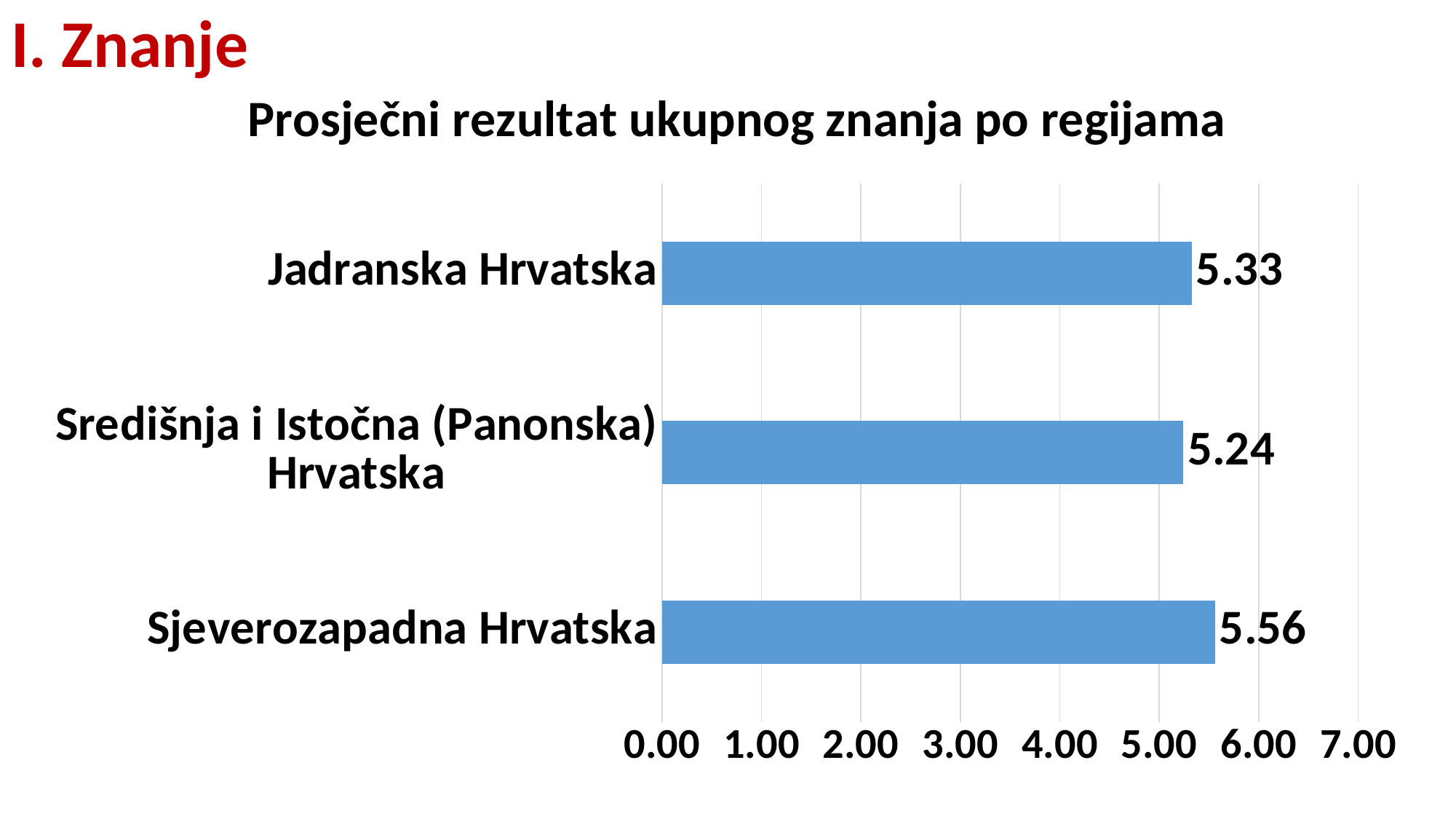
Which region has the lowest value? Središnja i Istočna (Panonska) Hrvatska What is the difference between the values for Jadranska Hrvatska and Središnja i Istočna (Panonska) Hrvatska? 0.09 What is the title of the chart? Prosječni rezultat ukupnog znanja po regijama Which region has the highest value? Sjeverozapadna Hrvatska What kind of chart is shown on the slide? bar chart Which is larger, the value for Sjeverozapadna Hrvatska or the value for Središnja i Istočna (Panonska) Hrvatska? Sjeverozapadna Hrvatska What is the value for Jadranska Hrvatska? 5.33 What is the difference between the values for Sjeverozapadna Hrvatska and Jadranska Hrvatska? 0.23 What is the value for Središnja i Istočna (Panonska) Hrvatska? 5.24 Is the value for Sjeverozapadna Hrvatska greater or less than 5.00? greater How many regions are shown in the chart? 3 What is the value for Sjeverozapadna Hrvatska? 5.56